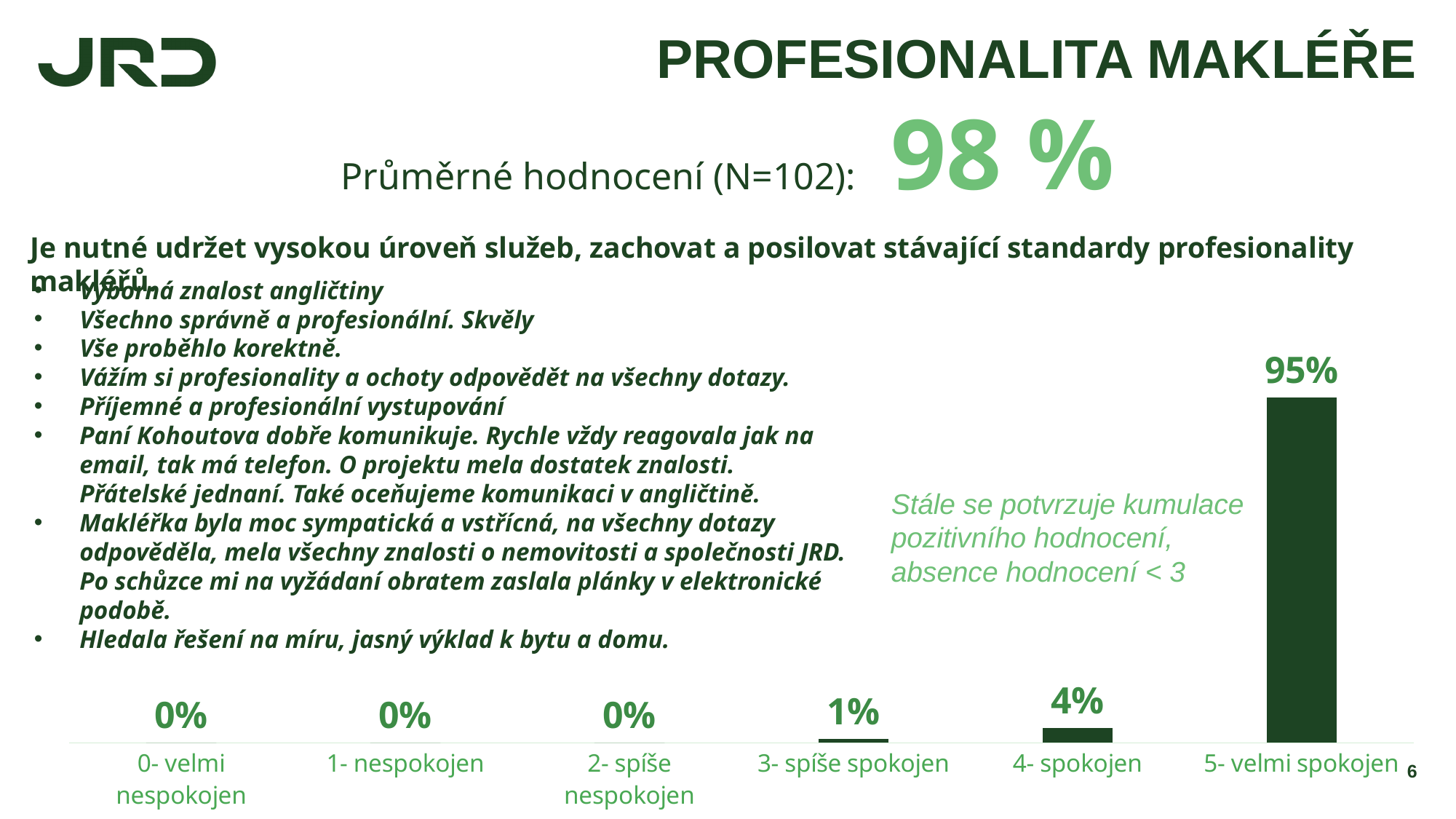
How many categories have a value of 0%? 3 What is the difference between the values for "5- velmi spokojen" and "4- spokojen"? 91% Do the values rise or fall from left to right along the x axis? rise Which category has the highest value? 5- velmi spokojen Which is larger, the value for "4- spokojen" or the value for "3- spíše spokojen"? 4- spokojen What is the value for the category "5- velmi spokojen"? 95% What is the value for the category "0- velmi nespokojen"? 0% What is the value for the category "4- spokojen"? 4% What kind of chart is shown on the slide? bar chart What is the difference between the values for "4- spokojen" and "3- spíše spokojen"? 3% What is the value for the category "3- spíše spokojen"? 1% How many categories are shown on the x axis of the chart? 6